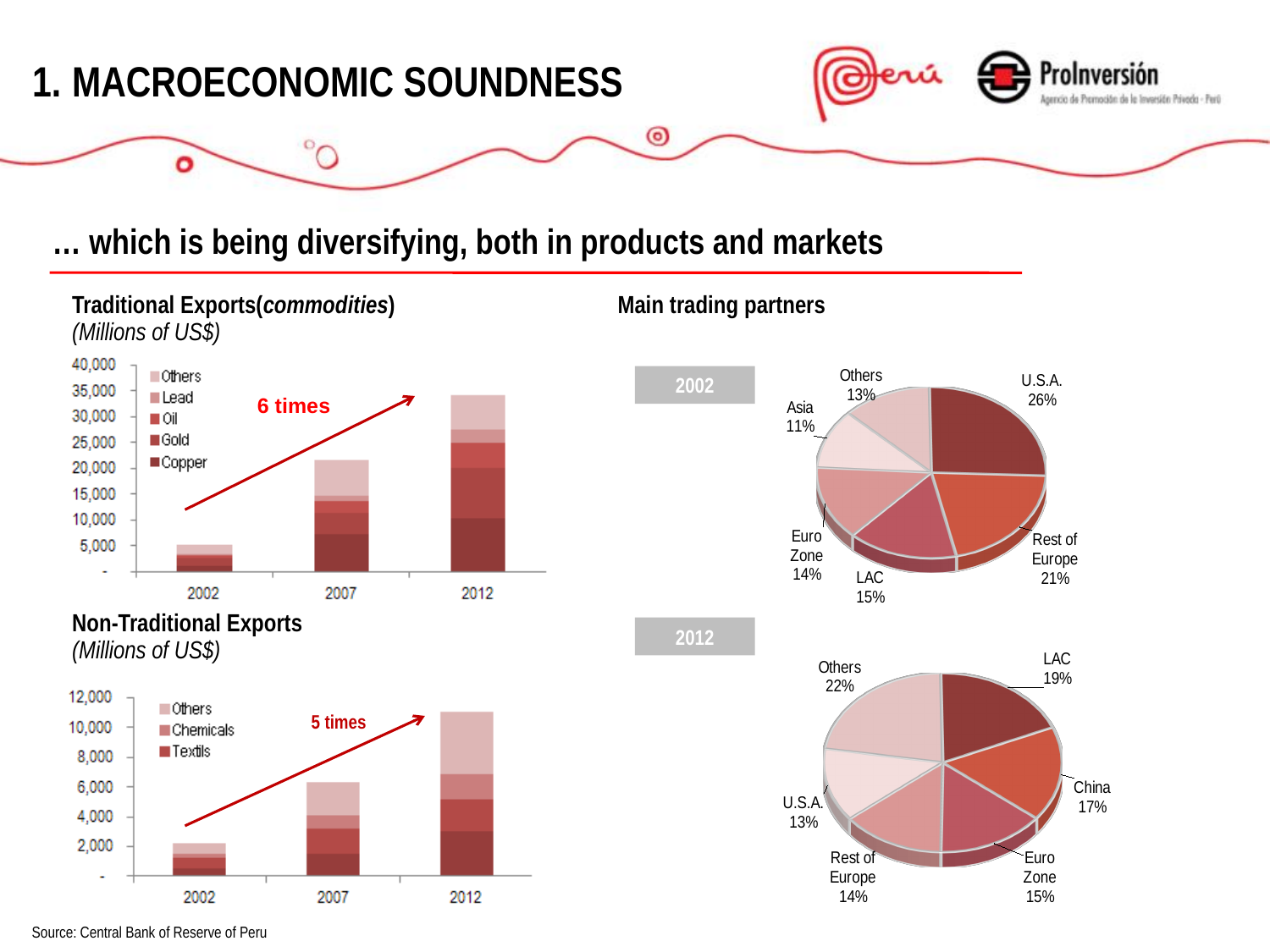
In the 2002 Main trading partners pie chart, which partner has the largest share? U.S.A. How many series does the legend of the Traditional Exports chart list? 5 In the 2002 Main trading partners pie chart, what share does U.S.A. have? 26% How many slices does the 2012 Main trading partners pie chart have? 6 In the Non-Traditional Exports chart, do the totals rise or fall from 2002 to 2012? Rise In the 2002 Main trading partners pie chart, which partner has the smallest share? Asia In the 2012 Main trading partners pie chart, which labelled partner has the smallest share? U.S.A. What kind of chart is the Non-Traditional Exports chart? Stacked bar chart In the 2012 Main trading partners pie chart, which is larger, LAC or China? LAC By how many percentage points did the U.S.A. share fall between the 2002 and 2012 Main trading partners pie charts? 13 percentage points In the 2012 Main trading partners pie chart, what share does China have? 17% In the Traditional Exports chart, is the total for 2012 greater or less than 30,000? greater